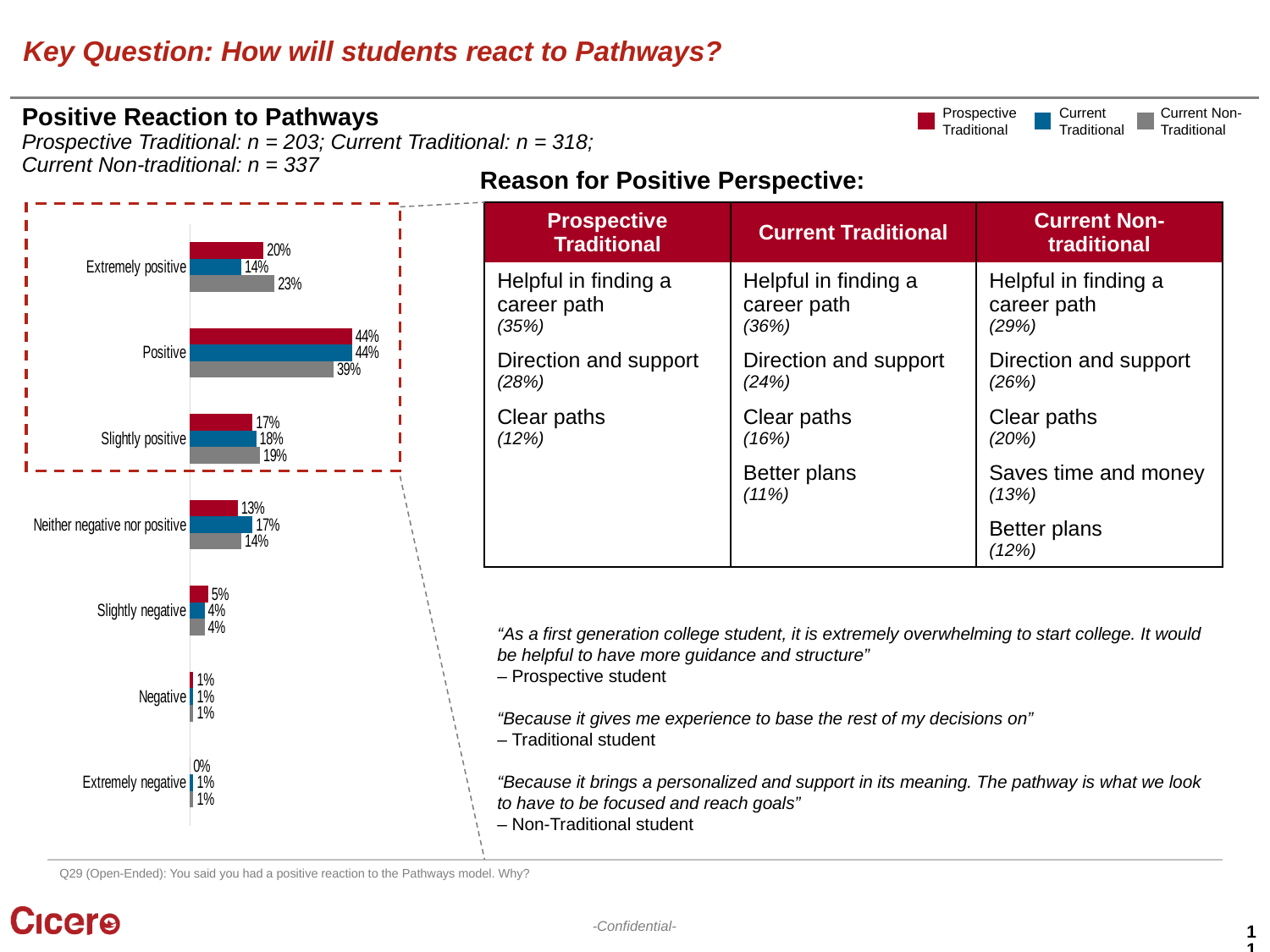
Which category has the lowest value for Prospective Traditional students? Extremely negative What is the value for Current Traditional students in the Neither negative nor positive category? 17% What is the value for Current Non-traditional students in the Extremely positive category? 23% What kind of chart is shown on the slide? Bar chart What is the difference between the Prospective Traditional and Current Traditional values in the Extremely positive category? 6% In the Positive category, which is larger: the Current Traditional value or the Current Non-traditional value? Current Traditional Which category has the highest value for Current Non-traditional students? Positive How many reaction categories are plotted on the chart? 7 Which colour represents Current Traditional students in the chart? Blue What is the value for Prospective Traditional students in the Slightly negative category? 5% What is the difference between the Current Non-traditional and Prospective Traditional values in the Slightly positive category? 2% How many series does the legend list? 3